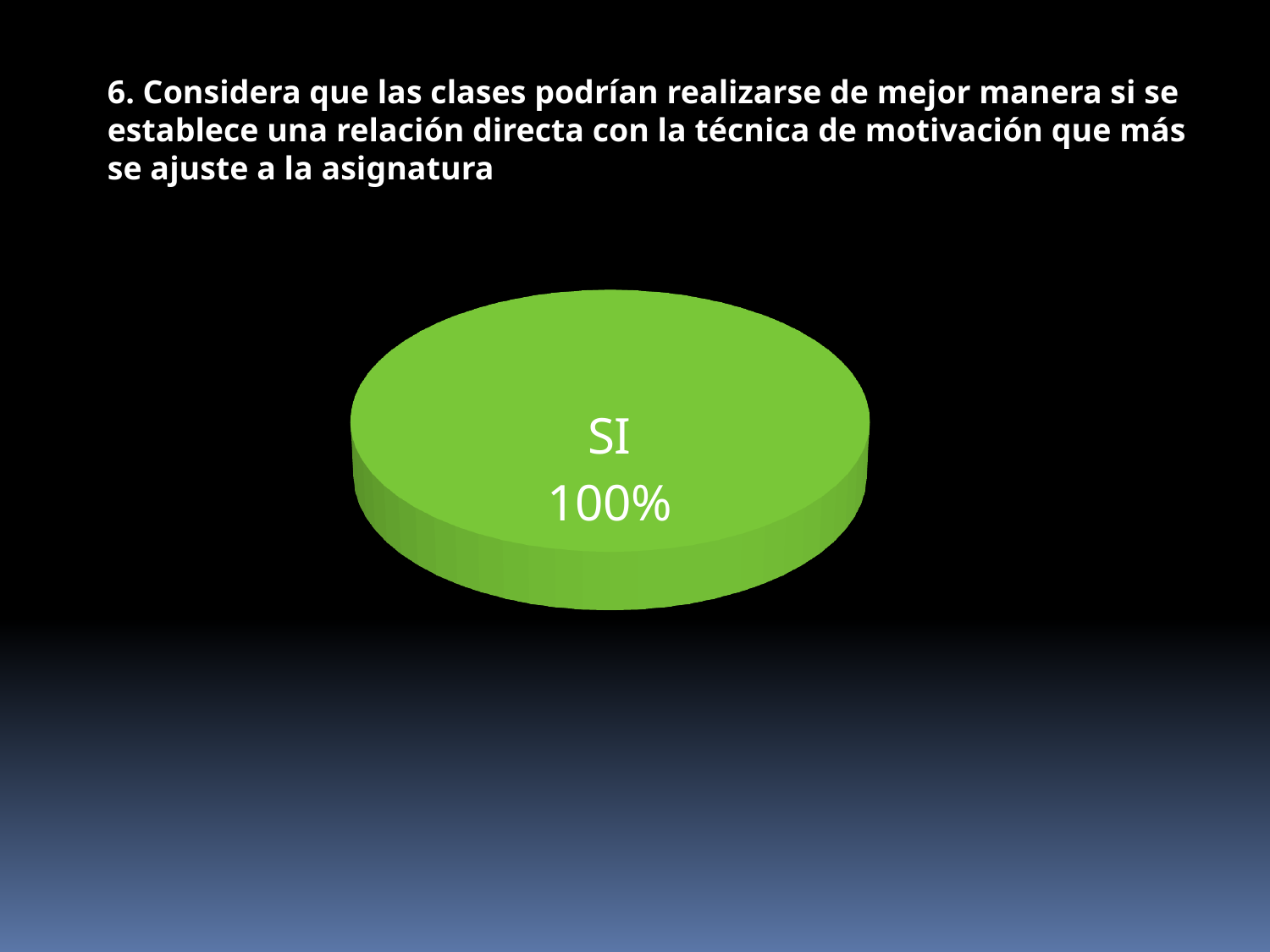
Which category makes up the entire pie? SI What is the label of the only slice in the pie chart? SI What colour is the SI slice? green How many slices does the pie chart have? 1 What percentage is shown for the SI slice? 100% What share of the pie does SI represent? 100% What kind of chart is shown on the slide? pie chart